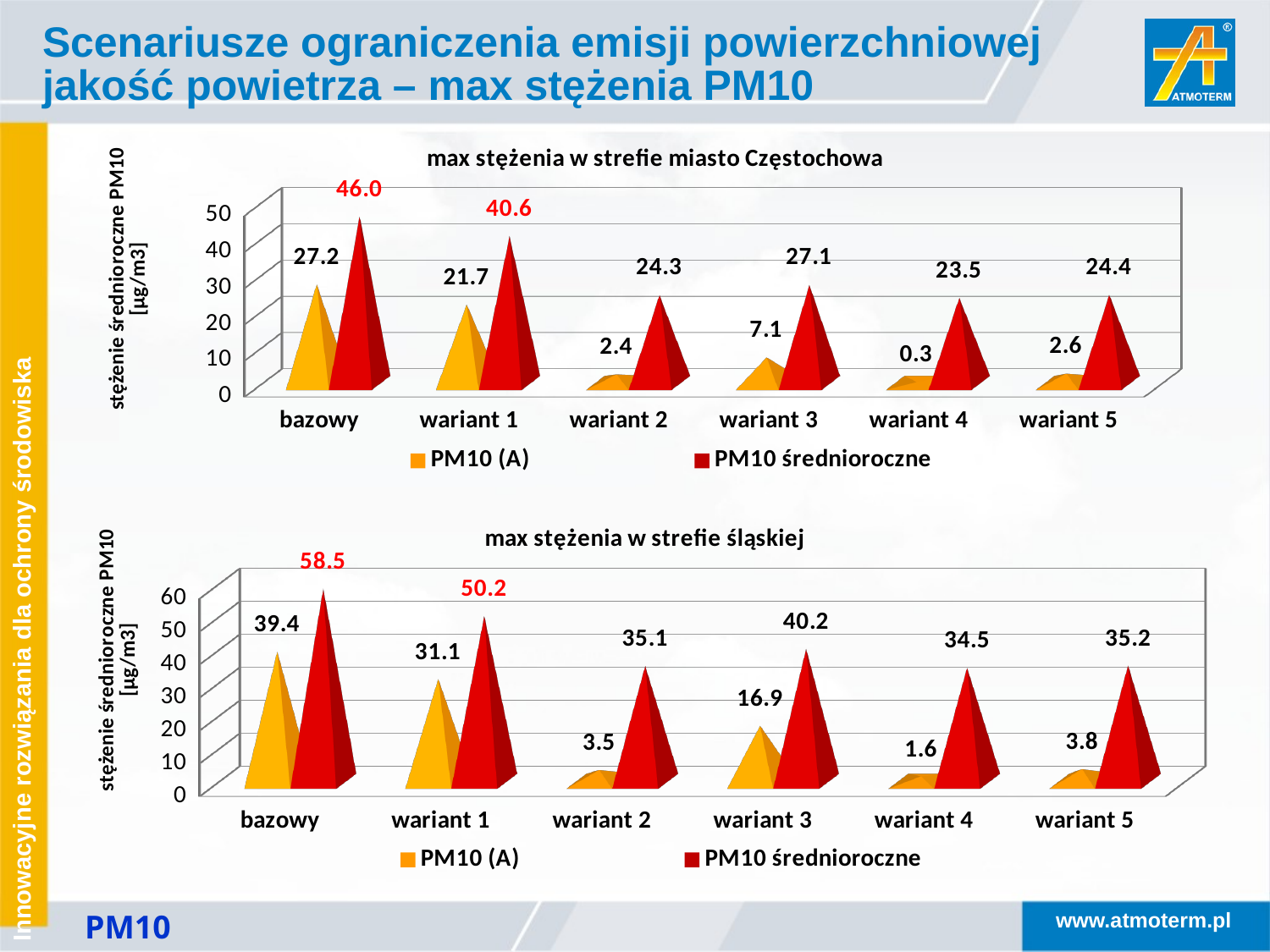
In the chart titled 'max stężenia w strefie miasto Częstochowa', what is the PM10 średnioroczne value for wariant 3? 27.1 In the chart titled 'max stężenia w strefie miasto Częstochowa', what is the difference between the PM10 średnioroczne values for bazowy and wariant 1? 5.4 In the chart titled 'max stężenia w strefie śląskiej', which is larger: the PM10 średnioroczne value for wariant 2 or for wariant 3? wariant 3 What kind of chart is the chart titled 'max stężenia w strefie śląskiej'? bar chart How many categories are shown on the x axis of the chart titled 'max stężenia w strefie miasto Częstochowa'? 6 In the chart titled 'max stężenia w strefie śląskiej', what is the difference between the PM10 (A) values for bazowy and wariant 3? 22.5 In the chart titled 'max stężenia w strefie miasto Częstochowa', what is the PM10 (A) value for bazowy? 27.2 How many series does the legend of the chart titled 'max stężenia w strefie śląskiej' list? 2 In the chart titled 'max stężenia w strefie miasto Częstochowa', which category has the lowest PM10 (A) value? wariant 4 In the chart titled 'max stężenia w strefie śląskiej', what is the PM10 średnioroczne value for wariant 1? 50.2 In the chart titled 'max stężenia w strefie śląskiej', which category has the highest PM10 średnioroczne value? bazowy In the chart titled 'max stężenia w strefie śląskiej', what is the PM10 (A) value for wariant 4? 1.6